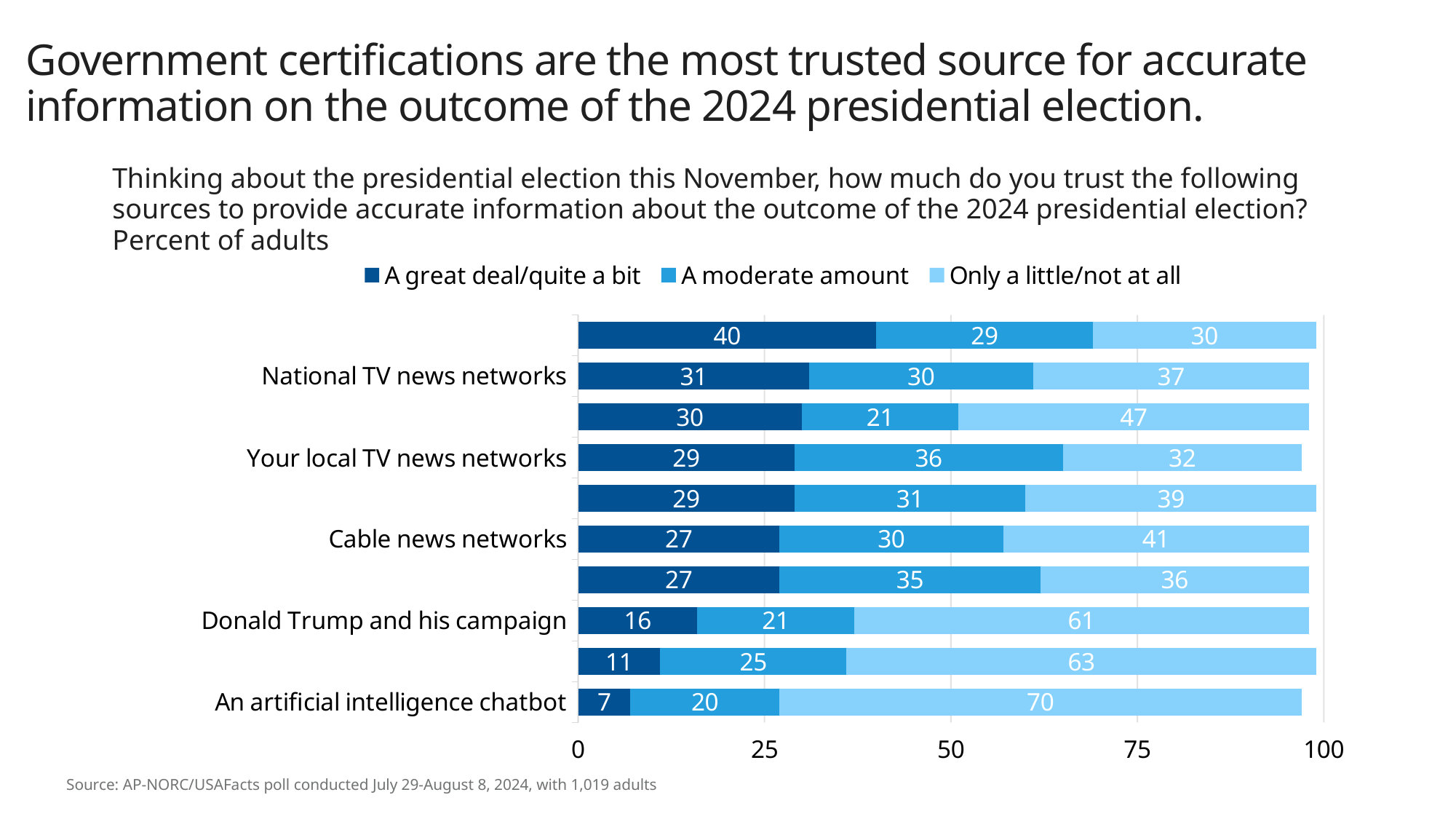
How many series does the legend list? 3 What is the 'A moderate amount' value for Your local TV news networks? 36 What is the 'A great deal/quite a bit' value for National TV news networks? 31 Which category has the highest 'Only a little/not at all' value? An artificial intelligence chatbot What is the difference between the 'Only a little/not at all' values for An artificial intelligence chatbot and Donald Trump and his campaign? 9 How many bars are plotted in the chart? 10 What is the total of the three segments in the bar for An artificial intelligence chatbot? 97 What kind of chart is shown on the slide? Stacked bar chart Which has a higher 'A great deal/quite a bit' value: National TV news networks or Cable news networks? National TV news networks What percentage of adults trust an artificial intelligence chatbot 'A great deal/quite a bit'? 7 What is the 'Only a little/not at all' value for Donald Trump and his campaign? 61 What is the 'Only a little/not at all' value for Cable news networks? 41